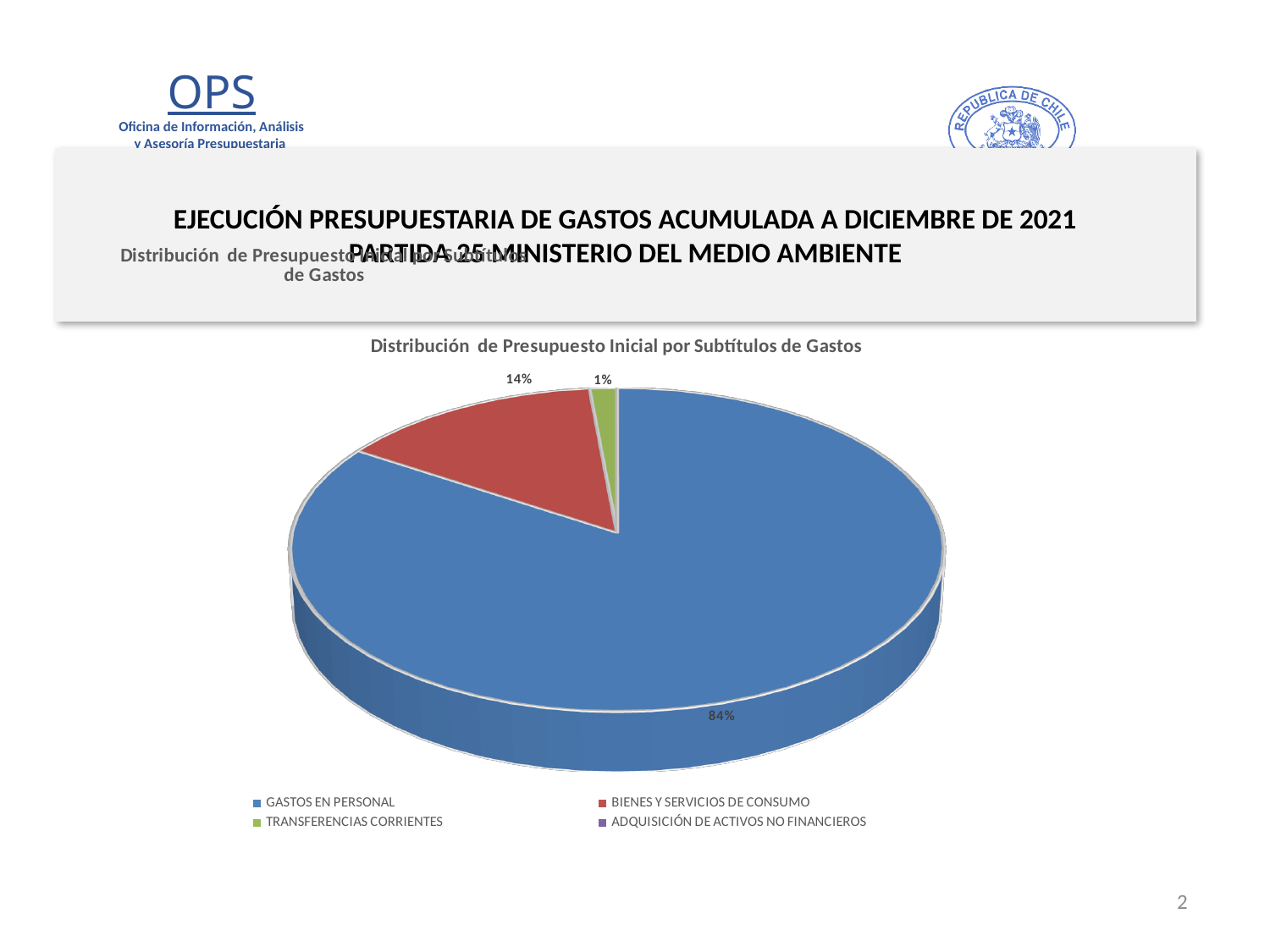
How many entries does the legend list? 4 What share of the pie does GASTOS EN PERSONAL represent? 84% What is the title of the chart? Distribución de Presupuesto Inicial por Subtítulos de Gastos Is the share for GASTOS EN PERSONAL greater or less than 50%? greater What share of the pie does BIENES Y SERVICIOS DE CONSUMO represent? 14% What share of the pie does TRANSFERENCIAS CORRIENTES represent? 1% Which category has the largest slice of the pie? GASTOS EN PERSONAL Which is larger, the slice for BIENES Y SERVICIOS DE CONSUMO or the slice for TRANSFERENCIAS CORRIENTES? BIENES Y SERVICIOS DE CONSUMO What is the difference in percentage points between the GASTOS EN PERSONAL slice and the BIENES Y SERVICIOS DE CONSUMO slice? 70 percentage points What kind of chart is shown on the slide? pie chart What colour is the slice for GASTOS EN PERSONAL? blue